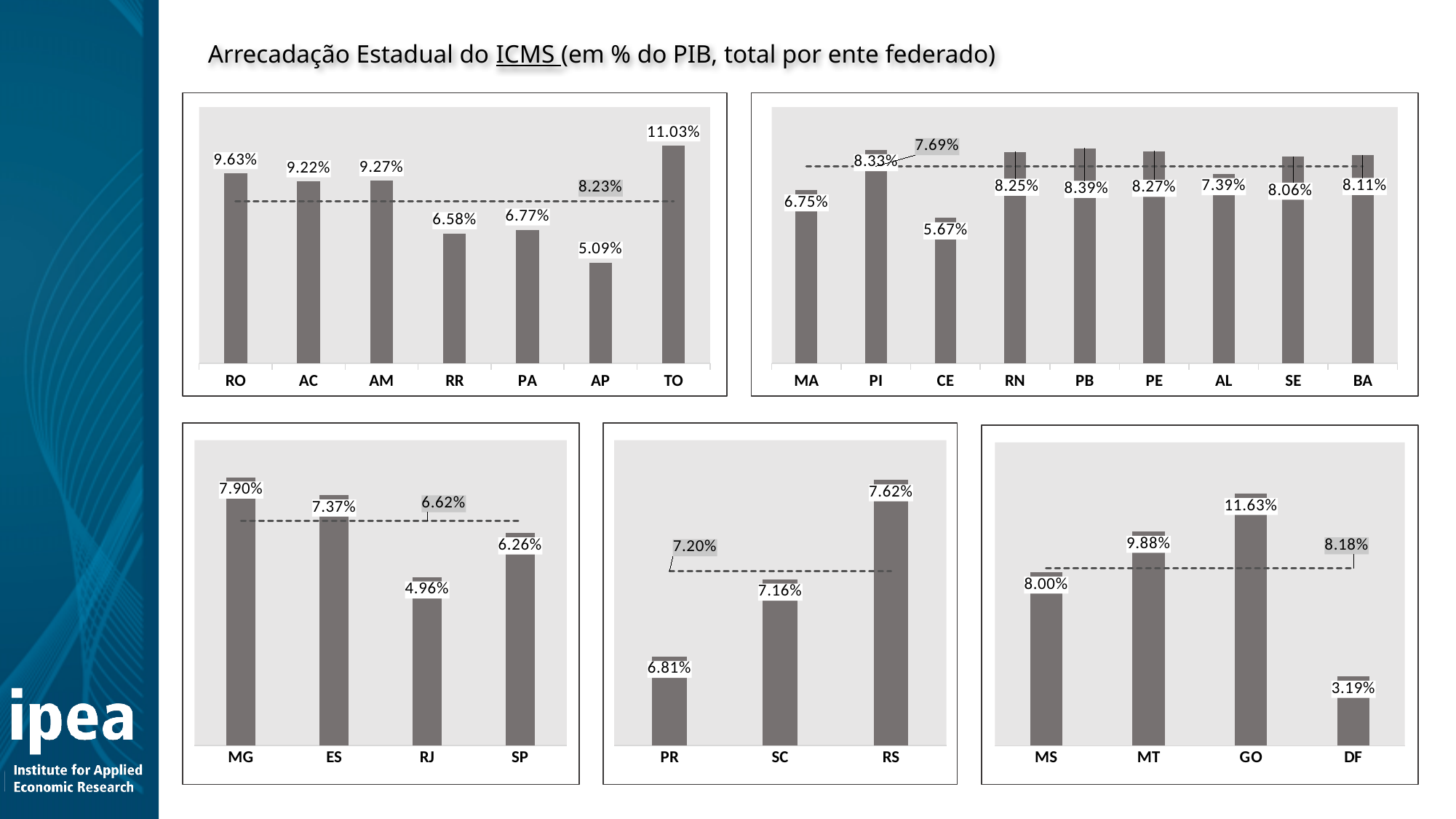
In the bottom-middle chart (PR, SC, RS), do the values rise or fall from left to right? rise In the bottom-right chart, what is the value for GO? 11.63% What kind of chart is used on this slide? bar chart In the bottom-left chart, which is larger, the value for MG or the value for ES? MG In the top-right chart, which state has the highest value? PB In the top-right chart, what is the value for CE? 5.67% In the bottom-right chart, what is the difference between the values for MT and DF? 6.69% How many states are shown in the top-right chart? 9 In the top-left chart, what is the difference between the values for RO and AC? 0.41% In the top-left chart, what is the value for TO? 11.03% In the top-left chart, which state has the lowest value? AP In the bottom-left chart, what is the value for RJ? 4.96%